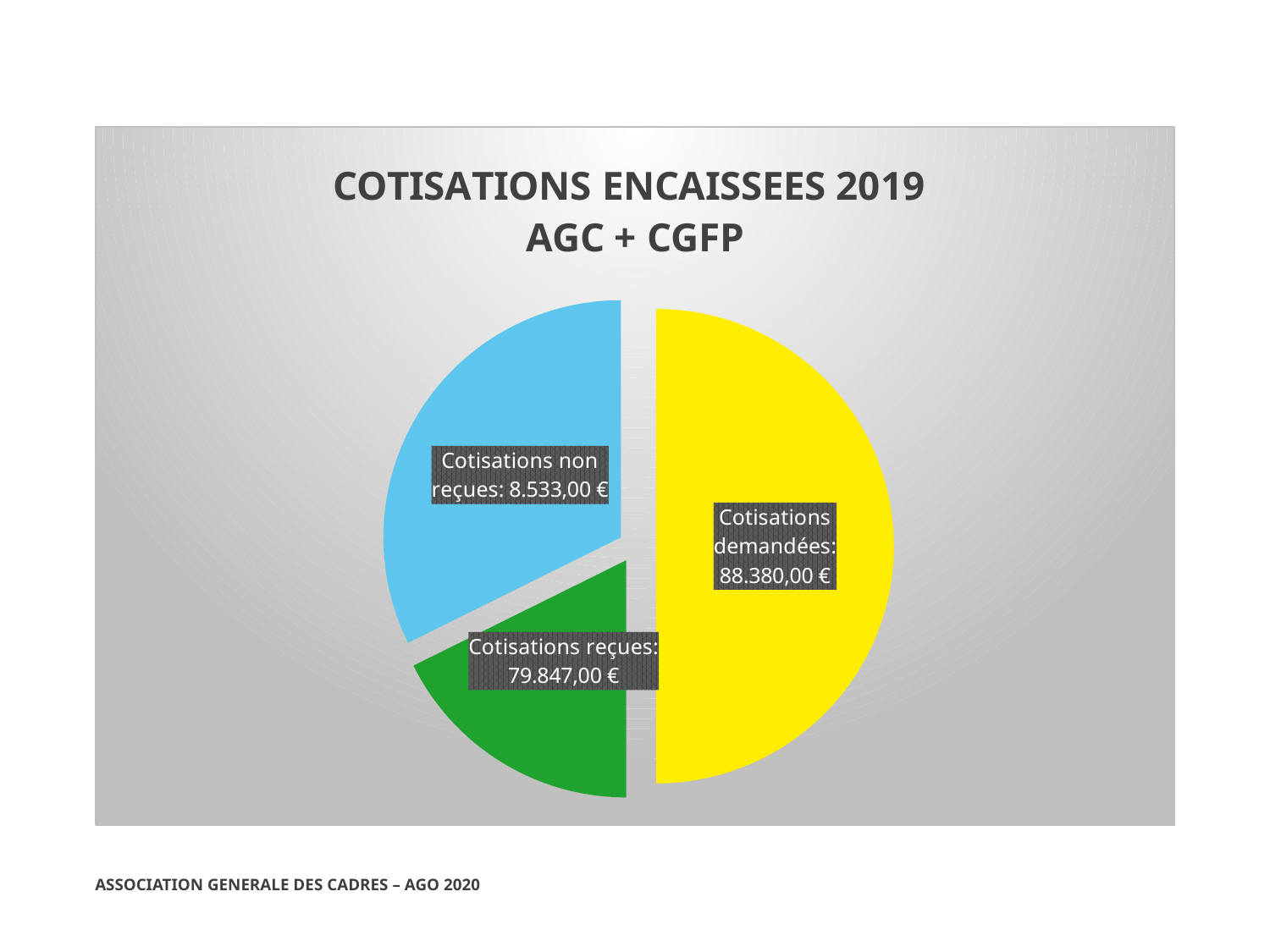
What kind of chart is shown on the slide? pie chart What is the title of the chart? COTISATIONS ENCAISSEES 2019 AGC + CGFP What is the value shown for Cotisations non reçues? 8.533,00 € What is the value shown for Cotisations demandées? 88.380,00 € How many slices does the pie chart have? 3 What is the difference between Cotisations demandées and Cotisations reçues? 8.533,00 € Which category is shown by the yellow slice? Cotisations demandées Which category has the highest value in the chart? Cotisations demandées Which is larger, Cotisations demandées or Cotisations reçues? Cotisations demandées What is the value shown for Cotisations reçues? 79.847,00 € Which category has the lowest value in the chart? Cotisations non reçues What is the difference between Cotisations reçues and Cotisations non reçues? 71.314,00 €